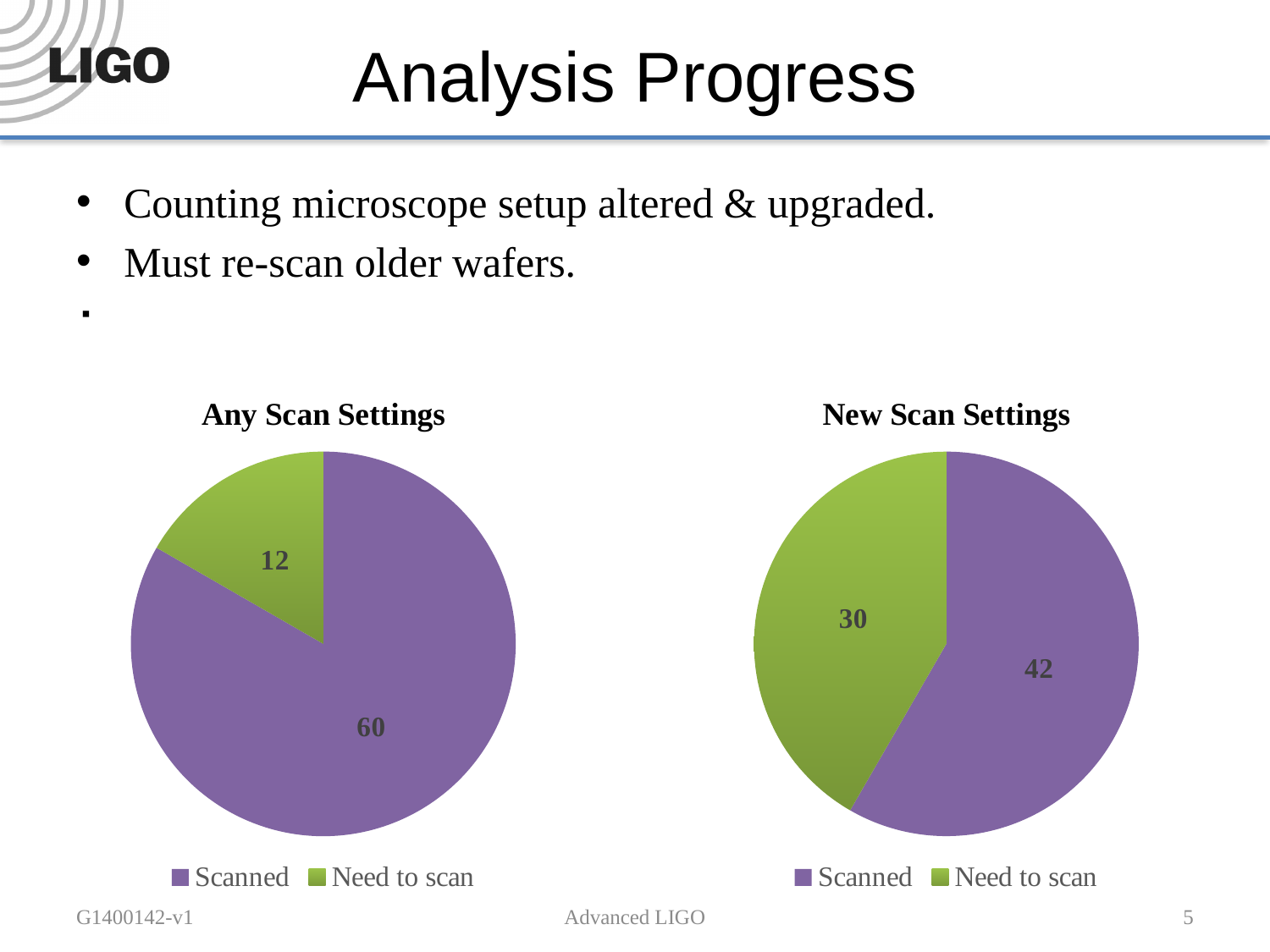
In the "New Scan Settings" chart, what is the difference between Scanned and Need to scan? 12 In the "Any Scan Settings" chart, what is the difference between Scanned and Need to scan? 48 What is the total of all slices in the "Any Scan Settings" chart? 72 In the "New Scan Settings" chart, what is the value for Scanned? 42 In the "Any Scan Settings" chart, what is the value for Scanned? 60 How many entries does the legend of the "Any Scan Settings" chart list? 2 In the "Any Scan Settings" chart, what is the value for Need to scan? 12 In the "New Scan Settings" chart, which category has the smallest slice? Need to scan In the "Any Scan Settings" chart, which category has the largest slice? Scanned What kind of chart is the "New Scan Settings" chart? Pie chart In the "New Scan Settings" chart, which is larger, Scanned or Need to scan? Scanned In the "New Scan Settings" chart, what is the value for Need to scan? 30